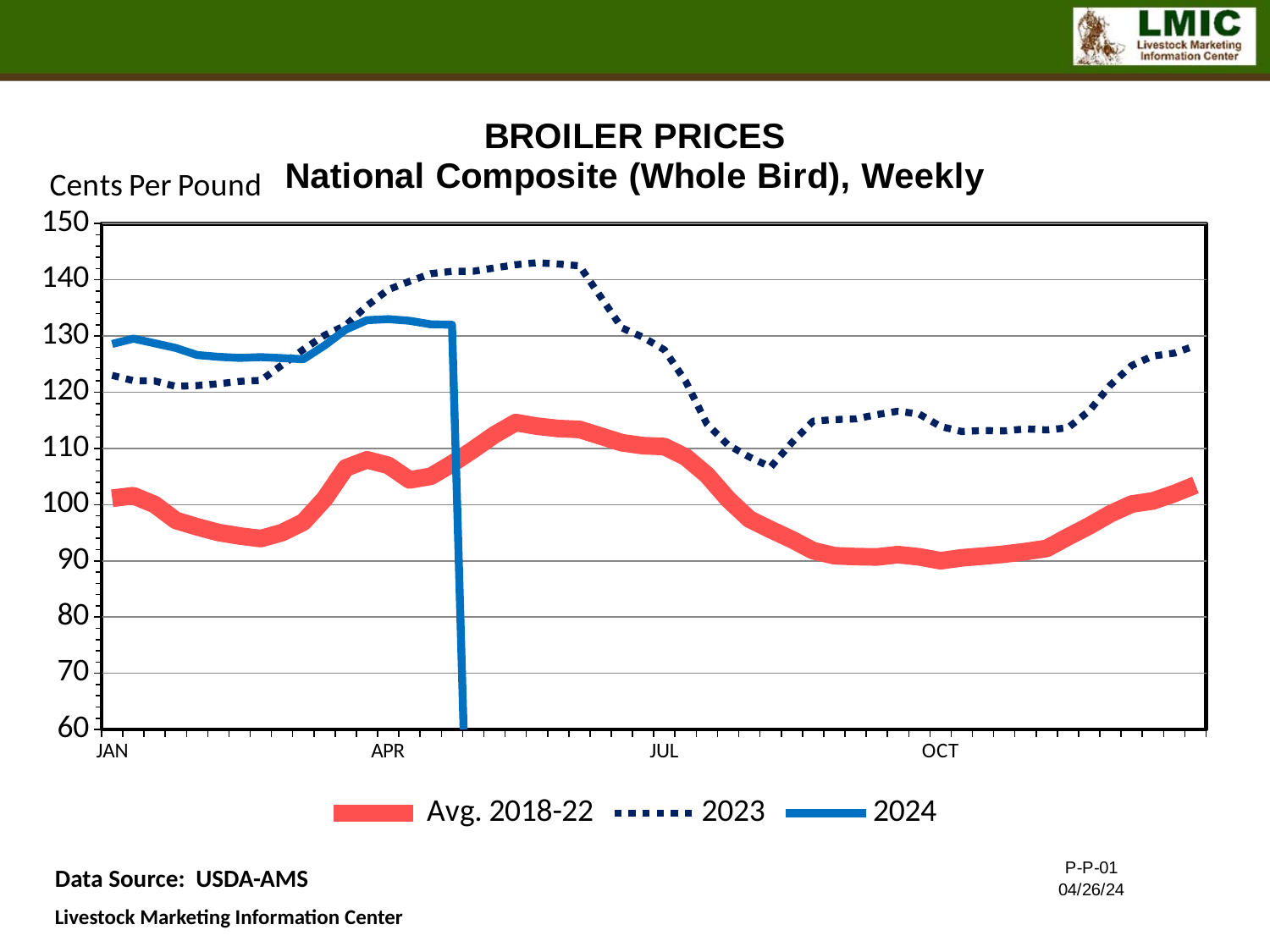
What kind of chart is shown on the slide? line chart Does the Avg. 2018-22 line rise or fall from July to October? fall Is the 2023 value in September greater or less than 110? greater Is the Avg. 2018-22 value in mid-May greater or less than 110? greater What is the unit shown on the y axis of the chart? Cents Per Pound How many series does the legend list? 3 Is the 2024 value in January greater or less than 120? greater What is the subtitle of the chart below 'BROILER PRICES'? National Composite (Whole Bird), Weekly How many month labels are shown on the x axis? 4 In January, which series is higher: 2024 or 2023? 2024 In July, which series is higher: 2023 or Avg. 2018-22? 2023